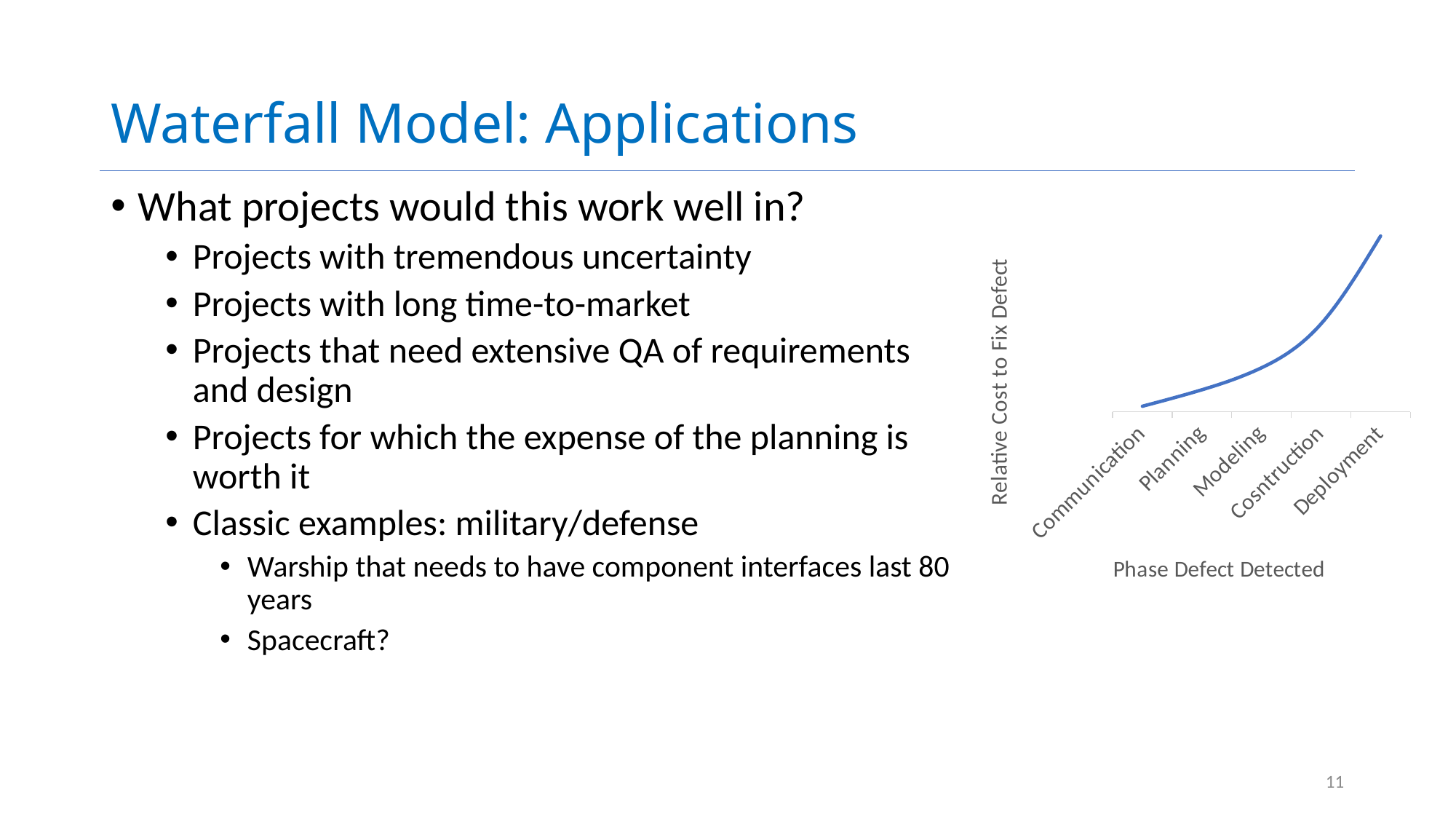
Which phase is listed first on the x axis of the chart? Communication What is the label of the horizontal axis of the chart? Phase Defect Detected Which phase has a higher relative cost to fix a defect, Deployment or Modeling? Deployment Which phase has the highest relative cost to fix a defect? Deployment What is the label of the vertical axis of the chart? Relative Cost to Fix Defect What kind of chart is shown on the slide? Line chart Which phase comes immediately after Modeling on the x axis? Cosntruction How many phases are shown along the x axis of the chart? 5 Which phase has a higher relative cost to fix a defect, Planning or Construction? Cosntruction Which phase has the lowest relative cost to fix a defect? Communication Does the relative cost to fix a defect rise or fall as the phases move from Communication to Deployment? Rise